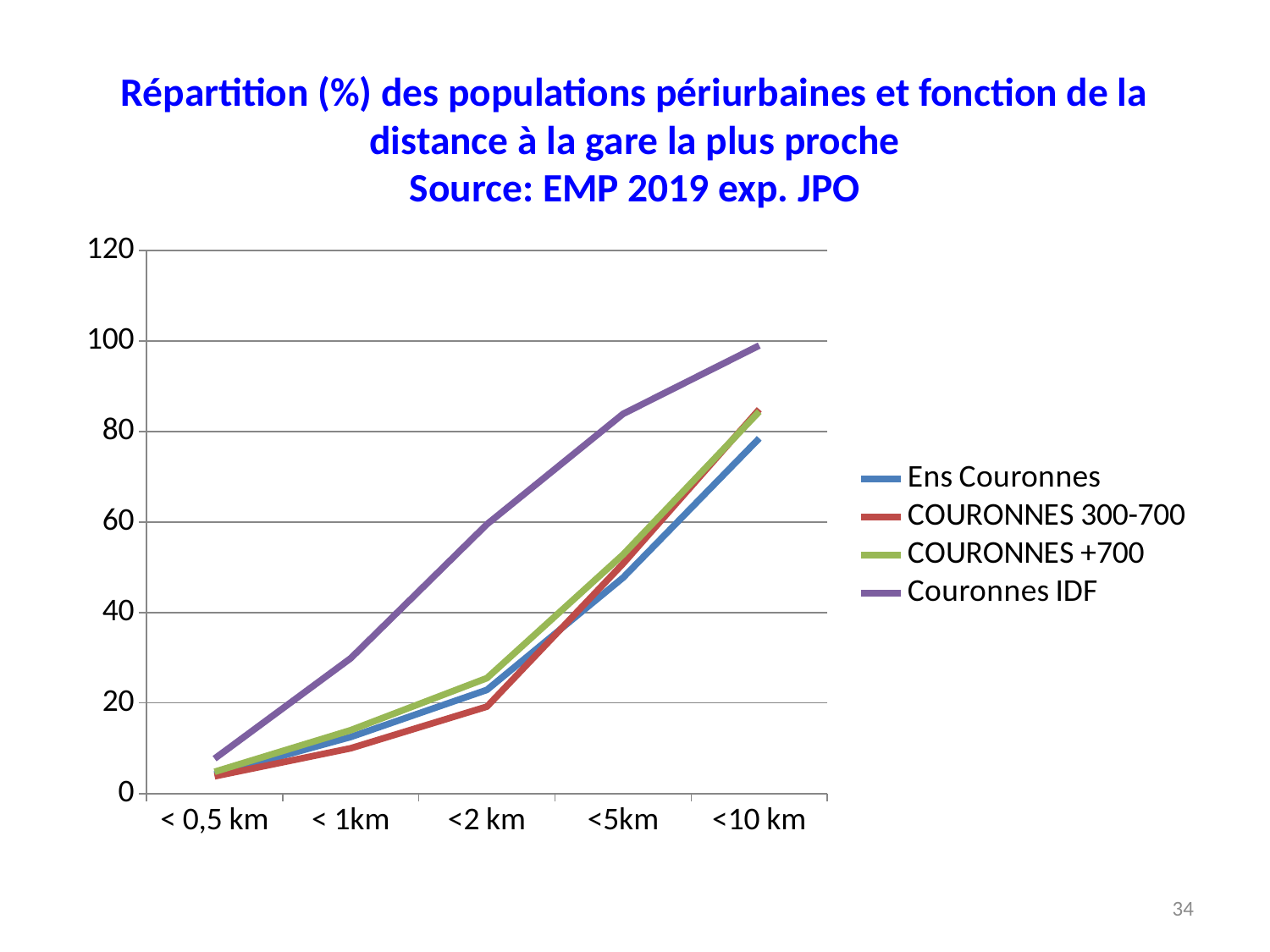
Do the values for Couronnes IDF rise or fall from < 0,5 km to <10 km? rise What kind of chart is shown on the slide? line chart At <2 km, which is larger: Couronnes IDF or Ens Couronnes? Couronnes IDF How many series does the legend list? 4 Which series has the lowest value at <2 km? COURONNES 300-700 Is the value for COURONNES 300-700 at <2 km greater or less than 40? less Is the value for Couronnes IDF at <5km greater or less than 60? greater Which series is drawn in purple? Couronnes IDF Which series has the highest value at < 0,5 km? Couronnes IDF How many distance categories are shown on the x axis? 5 Is the value for Couronnes IDF at < 1km greater or less than 20? greater